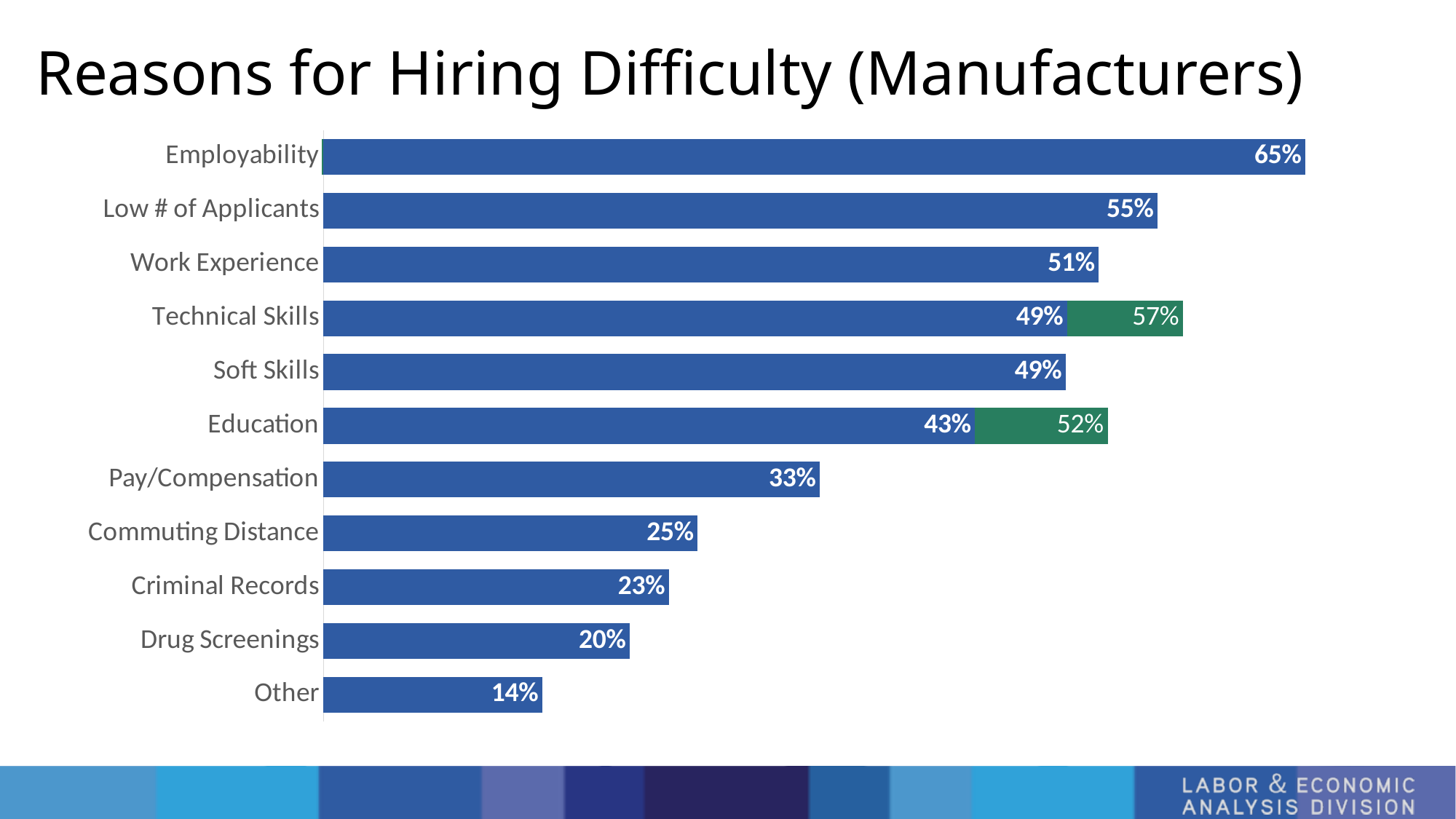
What is the value shown for Employability? 65% Which reasons have an additional green segment on their bar? Technical Skills and Education What is the difference between the values for Employability and Other? 51 percentage points How many reasons are listed on the chart? 11 What is the value shown for Drug Screenings? 20% What is the value shown for Pay/Compensation? 33% Which reason has the highest value? Employability What kind of chart is shown on the slide? Bar chart Which reason has the lowest value? Other What value is printed on the green segment of the Technical Skills bar? 57% What is the difference between the values for Low # of Applicants and Work Experience? 4 percentage points Which is larger, the value for Commuting Distance or the value for Criminal Records? Commuting Distance